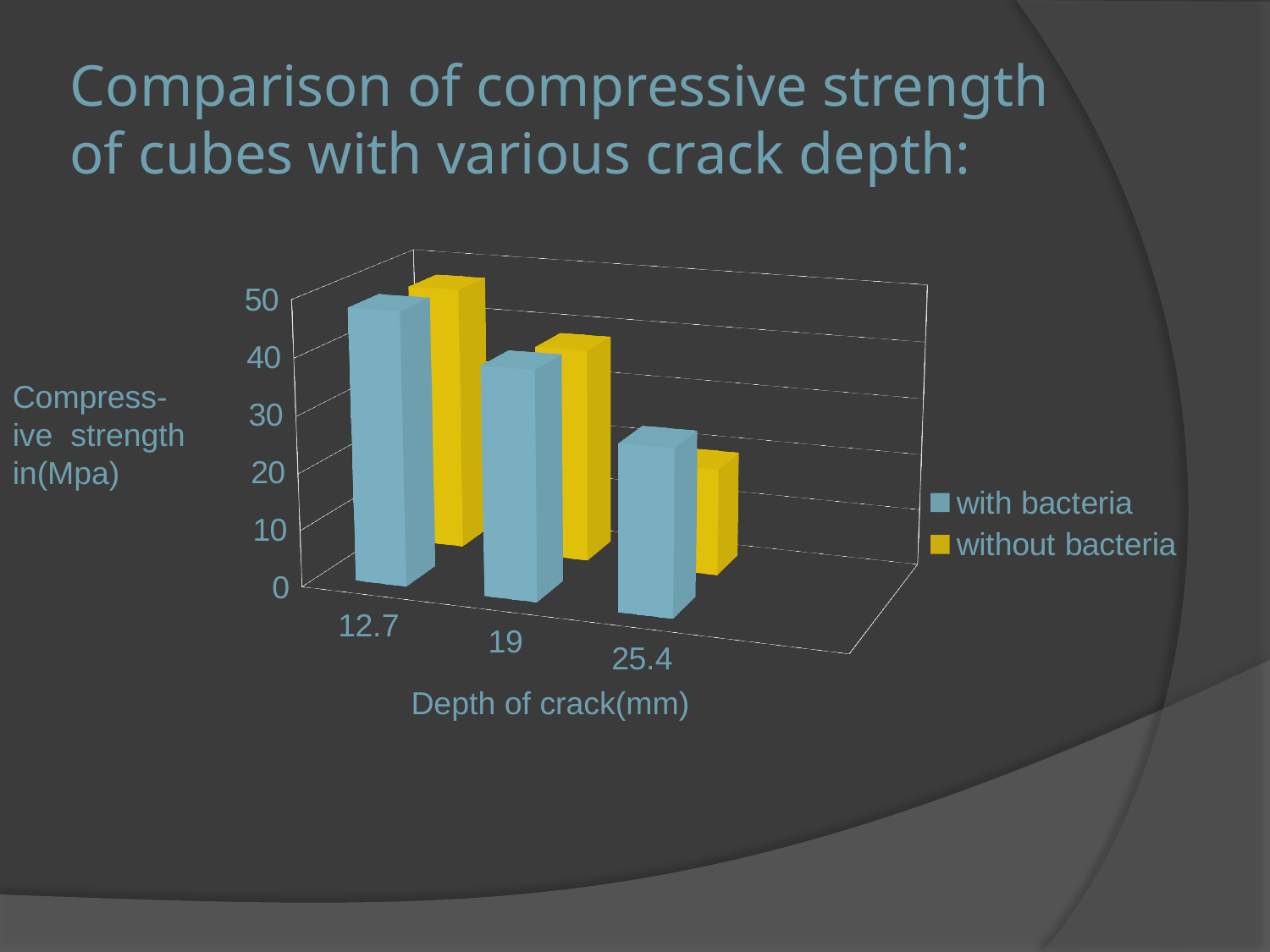
Is the compressive strength without bacteria at a crack depth of 25.4 mm greater or less than 30? less At which crack depth is the compressive strength without bacteria lowest? 25.4 How many series does the legend list? 2 Is the compressive strength with bacteria at a crack depth of 12.7 mm greater or less than 40? greater At which crack depth is the compressive strength with bacteria highest? 12.7 At which crack depth is the compressive strength with bacteria lowest? 25.4 What is the x-axis title of the chart? Depth of crack(mm) At a crack depth of 25.4 mm, which is larger: the compressive strength with bacteria or without bacteria? with bacteria How many crack depth categories are plotted on the x axis? 3 Which series are listed in the legend? with bacteria, without bacteria What kind of chart is shown on the slide? bar chart Does the compressive strength with bacteria rise or fall as the crack depth increases? fall